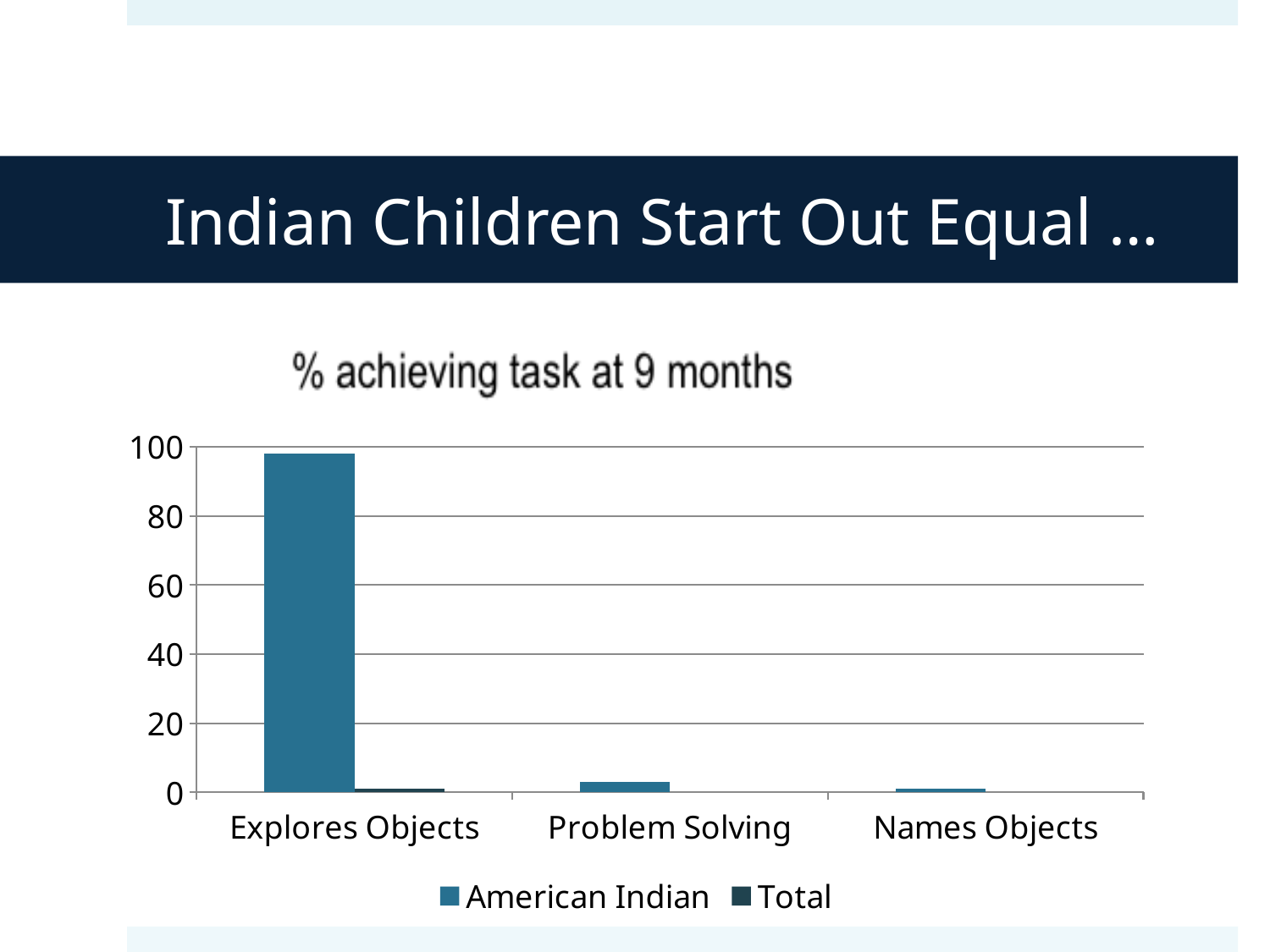
For the American Indian series, which is larger: Explores Objects or Problem Solving? Explores Objects Which category has the highest value for the American Indian series? Explores Objects Which two series are listed in the chart's legend? American Indian and Total Do the American Indian values rise or fall from Explores Objects to Names Objects along the x axis? fall How many series does the chart's legend list? 2 What kind of chart is shown on the slide? bar chart Which category has the lowest value for the American Indian series? Names Objects What is the title of the chart? % achieving task at 9 months How many categories are shown on the x axis of the chart? 3 Is the American Indian value for Explores Objects greater or less than 80? greater Is the American Indian value for Problem Solving greater or less than 20? less Is the Total value for Explores Objects greater or less than 20? less